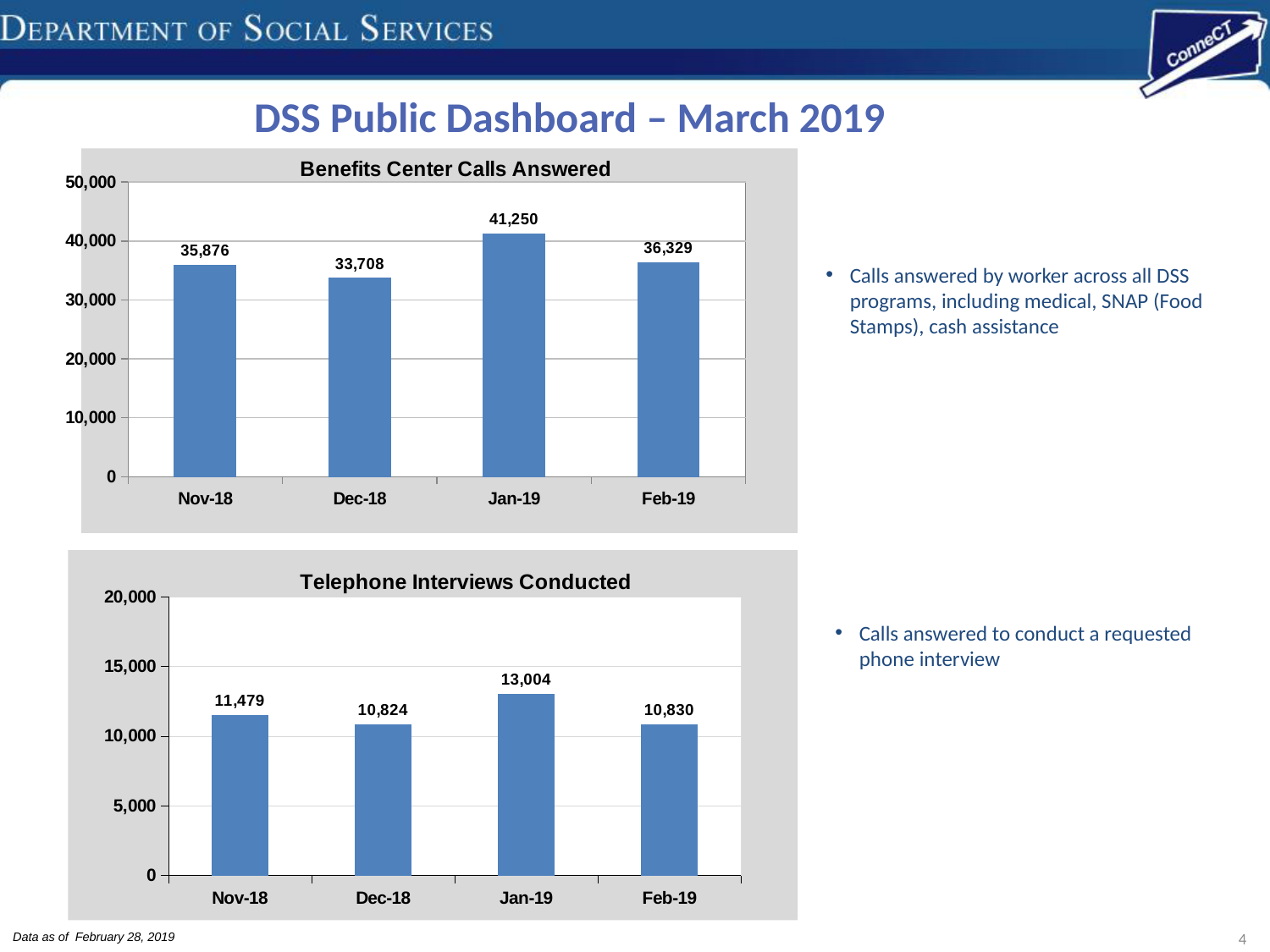
In the 'Telephone Interviews Conducted' chart, what is the value for Nov-18? 11,479 In the 'Telephone Interviews Conducted' chart, which month has the highest value? Jan-19 What kind of chart is the 'Telephone Interviews Conducted' chart? bar chart In the 'Benefits Center Calls Answered' chart, is the value for Feb-19 greater or less than 40,000? less What is the title of the top chart on the slide? Benefits Center Calls Answered In the 'Benefits Center Calls Answered' chart, which month has the lowest value? Dec-18 In the 'Benefits Center Calls Answered' chart, what is the value for Jan-19? 41,250 In the 'Benefits Center Calls Answered' chart, what is the difference between Jan-19 and Dec-18? 7,542 In the 'Telephone Interviews Conducted' chart, is the value for Jan-19 greater or less than 15,000? less In the 'Telephone Interviews Conducted' chart, which is larger, Nov-18 or Feb-19? Nov-18 In the 'Telephone Interviews Conducted' chart, what is the difference between Jan-19 and Feb-19? 2,174 In the 'Benefits Center Calls Answered' chart, how many months are shown? 4